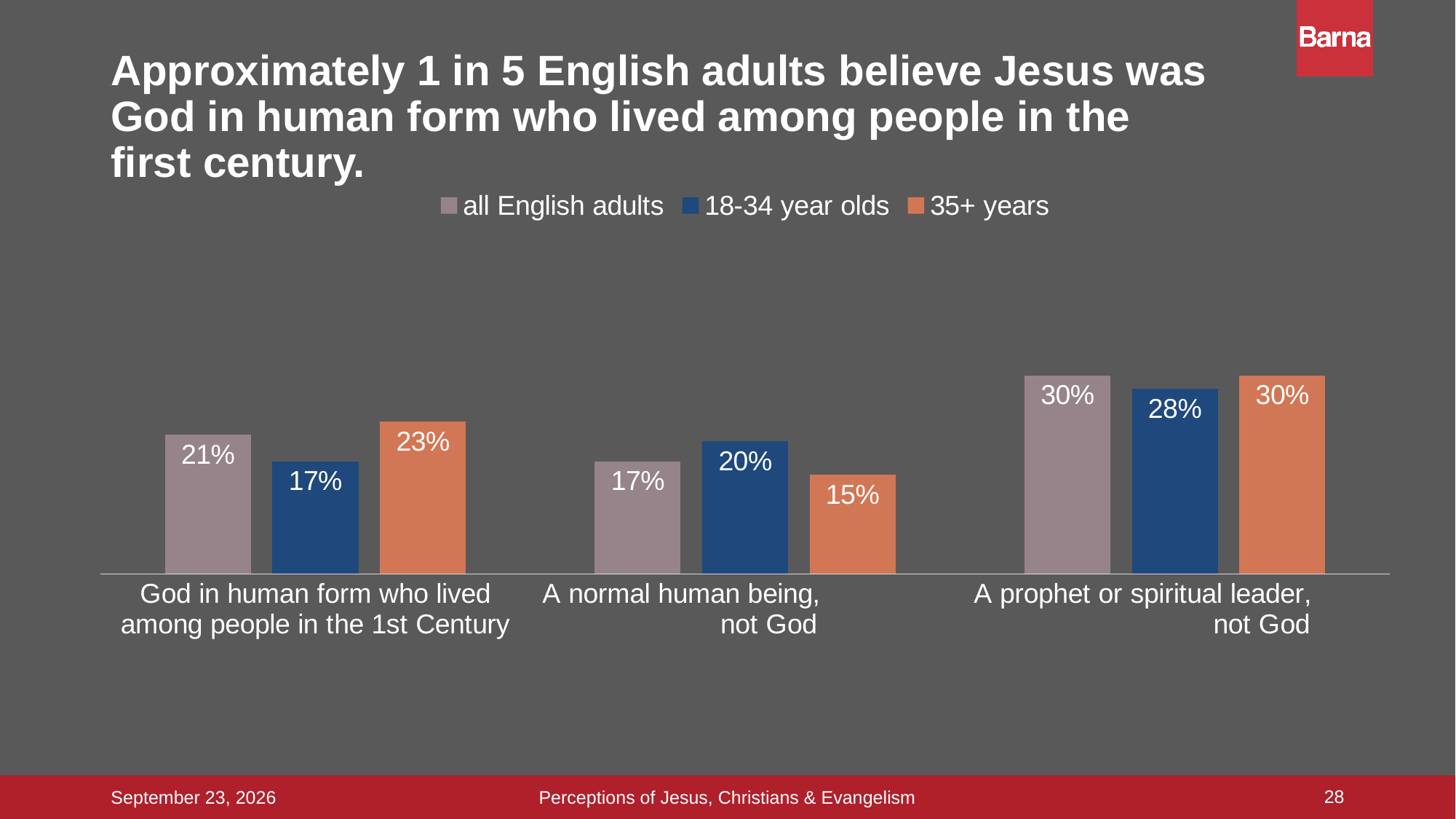
What is the value for 35+ years for 'A prophet or spiritual leader, not God'? 30% What percentage of all English adults believe Jesus was God in human form who lived among people in the 1st Century? 21% What is the difference between the 35+ years value and the 18-34 year olds value for 'God in human form who lived among people in the 1st Century'? 6% For 'A normal human being, not God', which group has the larger value: 18-34 year olds or 35+ years? 18-34 year olds What is the difference between all English adults and 18-34 year olds for 'A prophet or spiritual leader, not God'? 2% Which series is shown in orange in the legend? 35+ years What kind of chart is shown on the slide? Bar chart Which category has the lowest value for 35+ years? A normal human being, not God What is the value for 18-34 year olds for 'A normal human being, not God'? 20% How many series does the legend list? 3 How many categories are shown on the x axis? 3 Which category has the highest value for 18-34 year olds? A prophet or spiritual leader, not God